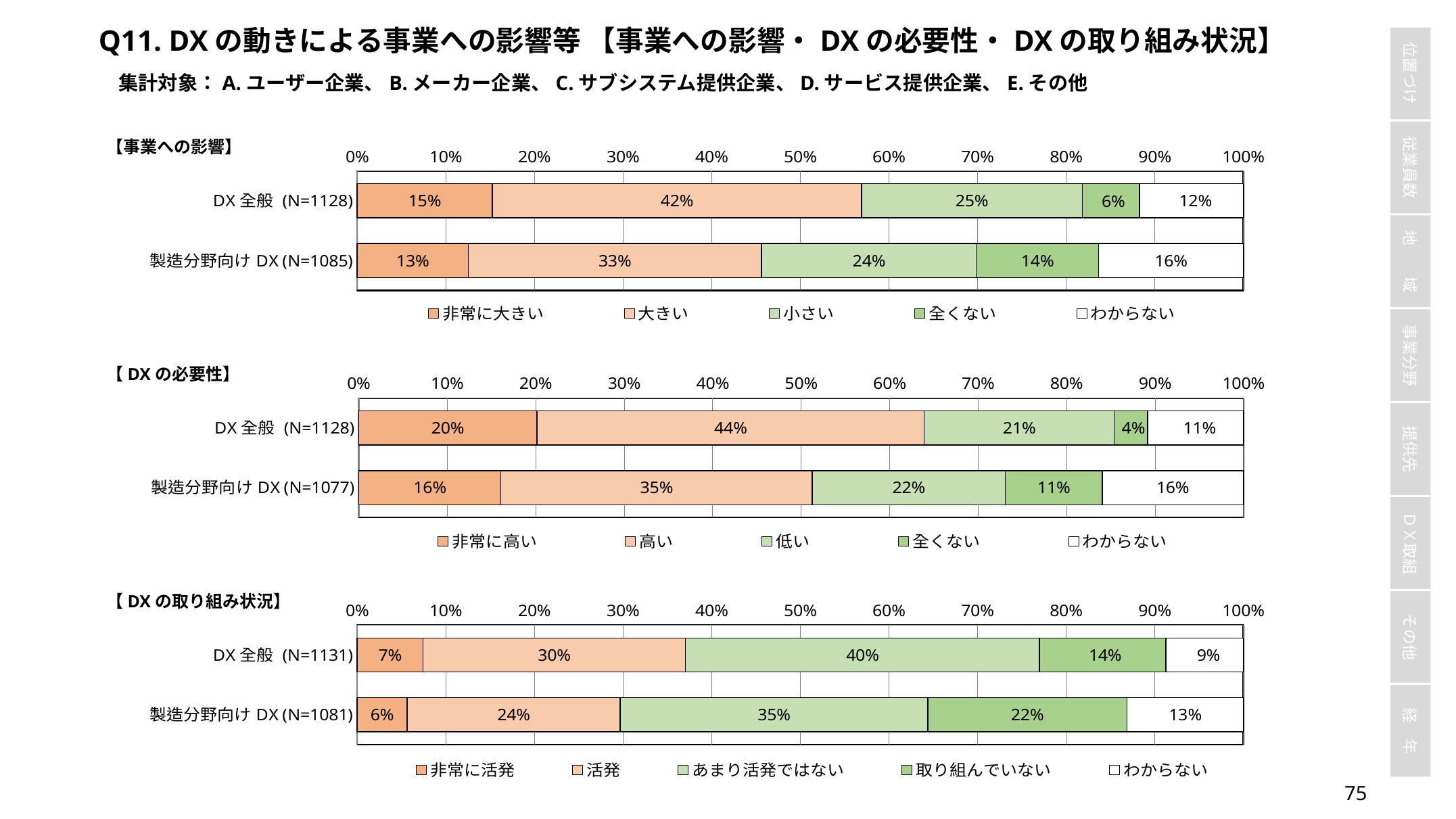
In the 【事業への影響】 chart, what is the value of 全くない for 製造分野向け DX (N=1085)? 14% In the 【 DX の必要性】 chart, which segment is the largest for 製造分野向け DX (N=1077)? 高い What kind of chart is the 【事業への影響】 chart? Stacked bar chart In the 【事業への影響】 chart, what is the difference between the 非常に大きい values for DX 全般 and 製造分野向け DX? 2% How many bars (categories) are shown in the 【 DX の必要性】 chart? 2 In the 【 DX の取り組み状況】 chart, what is the value of あまり活発ではない for DX 全般 (N=1131)? 40% In the 【 DX の必要性】 chart, which segment is the smallest for DX 全般 (N=1128)? 全くない In the 【 DX の必要性】 chart, what is the value of 非常に高い for DX 全般 (N=1128)? 20% How many series does the legend of the 【 DX の取り組み状況】 chart list? 5 In the 【 DX の取り組み状況】 chart, what is the difference between the 活発 values for DX 全般 and 製造分野向け DX? 6% In the 【事業への影響】 chart, what is the value of 大きい for DX 全般 (N=1128)? 42% In the 【 DX の取り組み状況】 chart, which is larger: 取り組んでいない for DX 全般 or for 製造分野向け DX? 製造分野向け DX